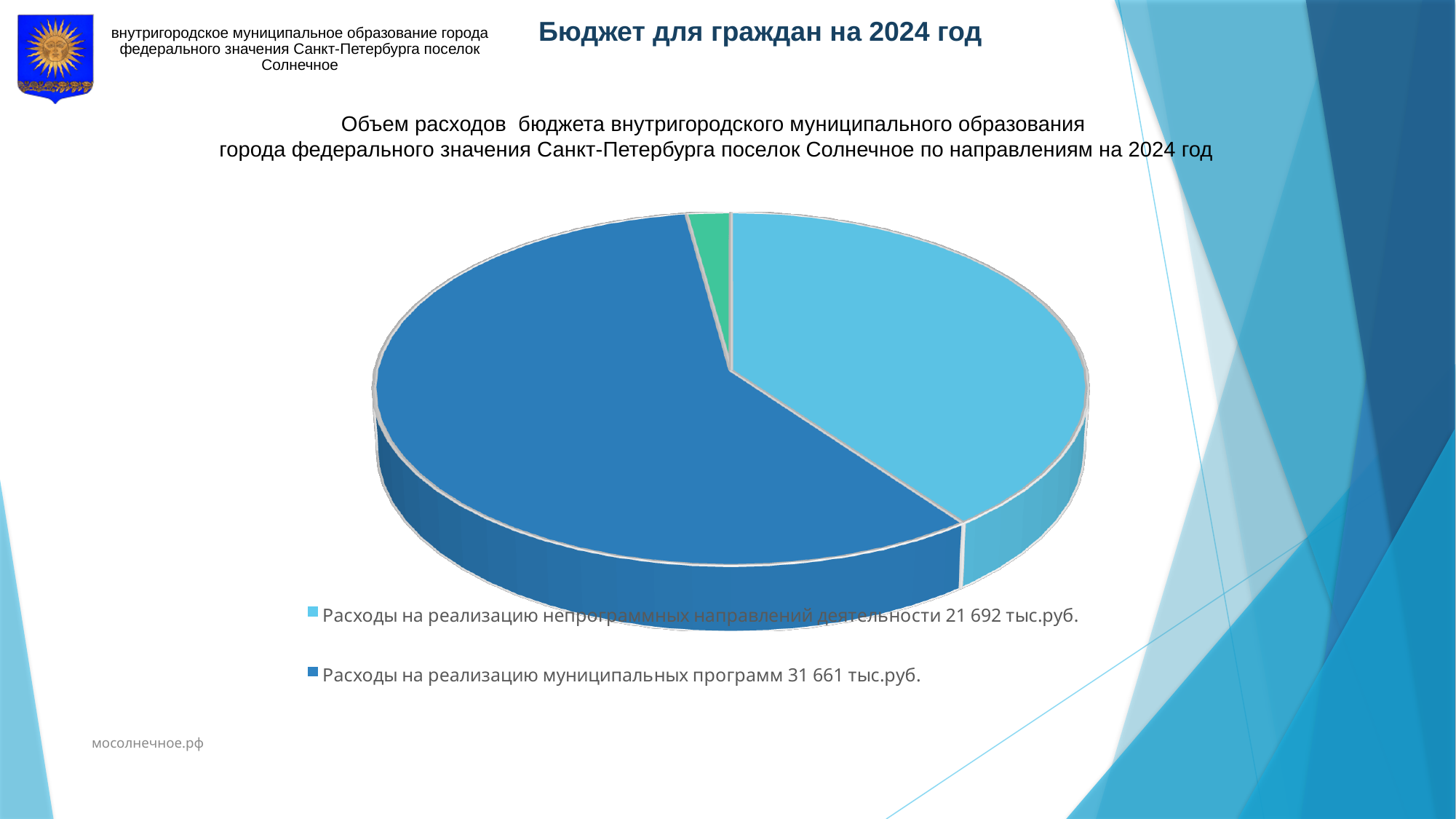
How many entries does the chart legend list? 2 What kind of chart is shown on the slide? pie chart How many slices does the pie chart have? 3 What colour is the slice for "Расходы на реализацию непрограммных направлений деятельности"? light blue What is the difference between the value for "Расходы на реализацию муниципальных программ" and the value for "Расходы на реализацию непрограммных направлений деятельности"? 9 969 тыс.руб. What colour is the slice for "Расходы на реализацию муниципальных программ"? dark blue What is the value for "Расходы на реализацию муниципальных программ"? 31 661 тыс.руб. What is the value for "Расходы на реализацию непрограммных направлений деятельности"? 21 692 тыс.руб. Which category takes the largest slice of the pie? Расходы на реализацию муниципальных программ Which of the two legend categories has the larger value: "Расходы на реализацию непрограммных направлений деятельности" or "Расходы на реализацию муниципальных программ"? Расходы на реализацию муниципальных программ